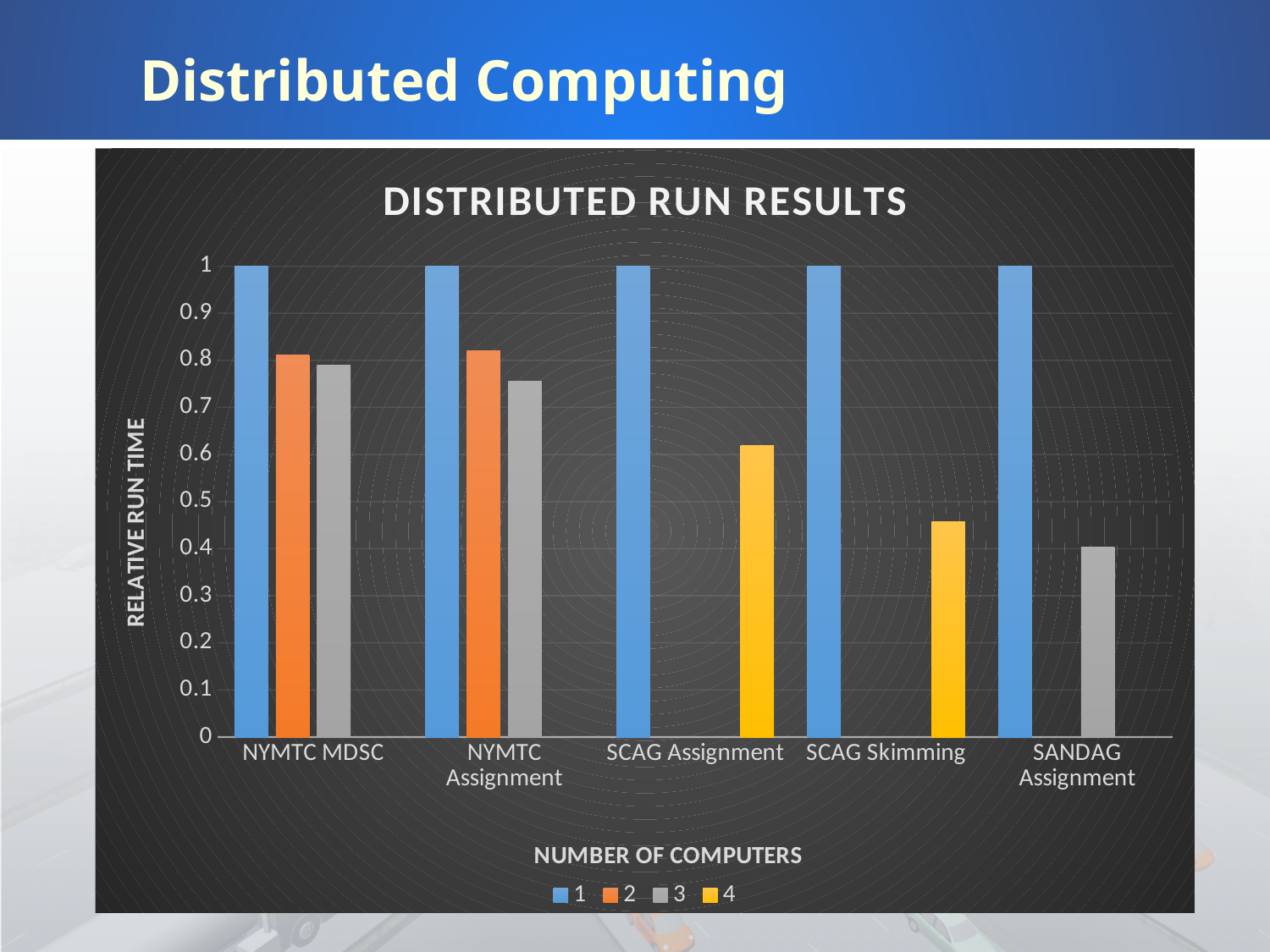
What is the label of the y axis? RELATIVE RUN TIME Is the relative run time for SCAG Assignment with 4 computers greater or less than 0.7? less What kind of chart is shown on the slide? bar chart What is the title of the chart? DISTRIBUTED RUN RESULTS What is the relative run time for NYMTC MDSC with 1 computer? 1 What is the relative run time for SCAG Skimming with 1 computer? 1 Which is larger: the relative run time for NYMTC Assignment with 3 computers or for SANDAG Assignment with 3 computers? NYMTC Assignment with 3 computers How many series does the chart's legend list? 4 How many categories are shown on the x axis of the chart? 5 Is the relative run time for NYMTC MDSC with 2 computers greater or less than 0.7? greater Is the relative run time for SCAG Skimming with 4 computers greater or less than 0.5? less Which category has the lowest relative run time for 3 computers? SANDAG Assignment